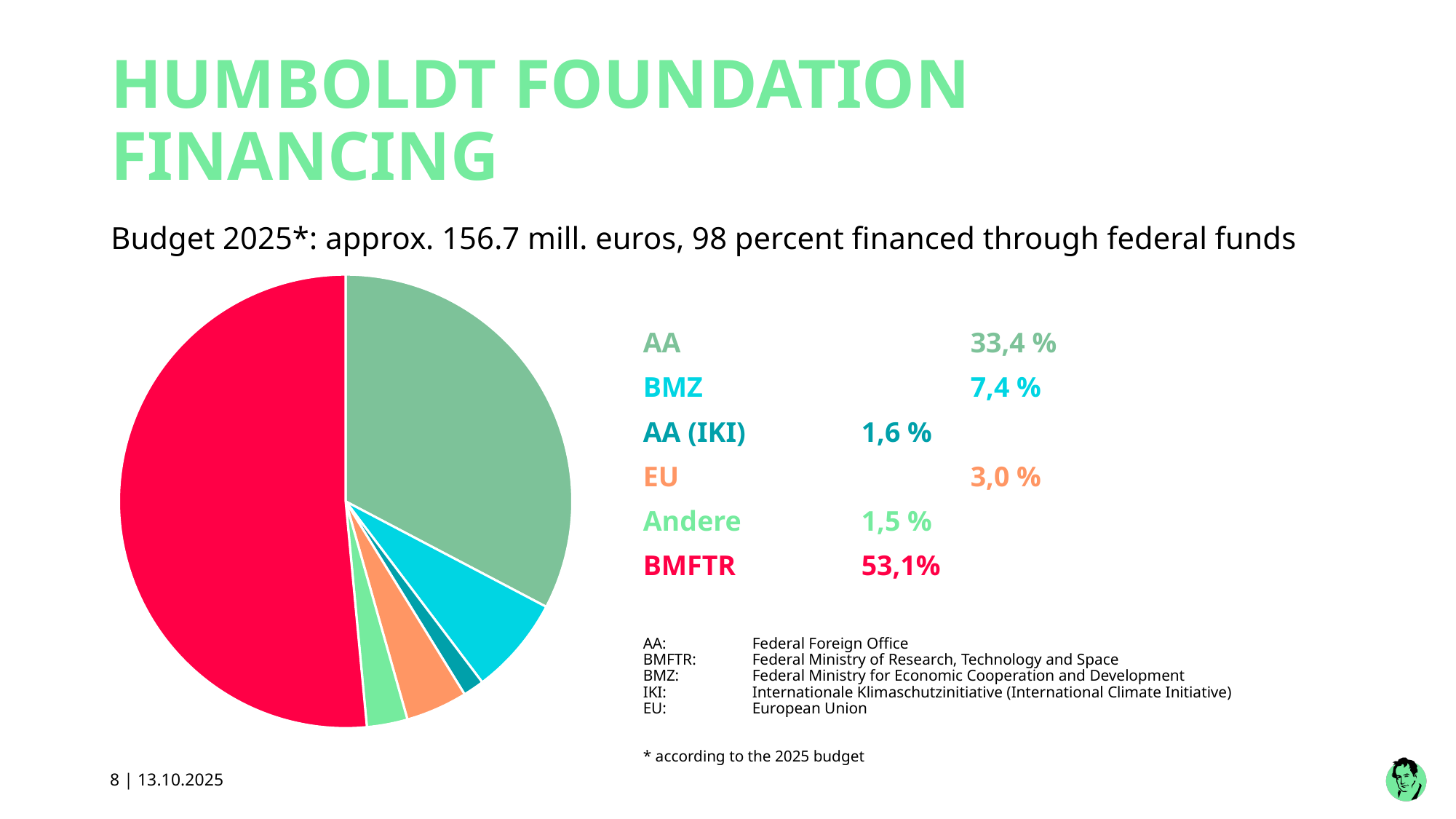
What share of the budget comes from AA (IKI)? 1,6 % What kind of chart is shown on the slide? pie chart Which funding source has the smallest share of the pie? Andere What share of the budget comes from the EU? 3,0 % What colour is the BMFTR slice of the pie? red How many slices does the pie chart have? 6 Which funding source has the largest share of the pie? BMFTR What is the difference in percentage points between the BMFTR share and the AA share? 19,7 What share of the budget comes from BMFTR? 53,1% What share of the budget comes from BMZ? 7,4 % Which is larger, the share for BMZ or the share for EU? BMZ What share of the budget comes from AA? 33,4 %